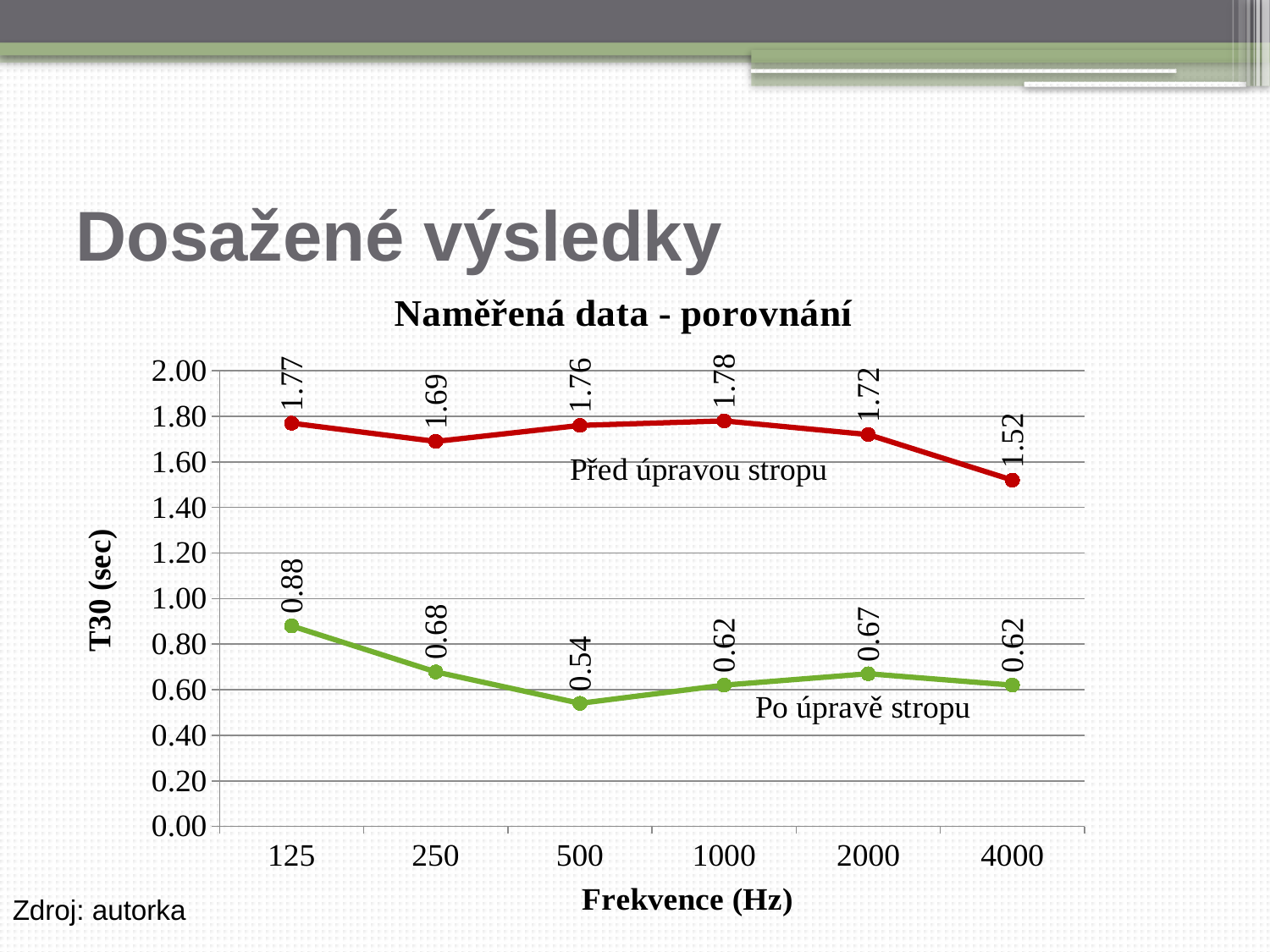
What type of chart is shown on the slide? line chart What is the T30 value for 'Po úpravě stropu' at 500 Hz? 0.54 How many frequency points are plotted on the x axis? 6 Which is larger for 'Po úpravě stropu': the value at 250 Hz or the value at 2000 Hz? 250 Hz At which frequency is the 'Před úpravou stropu' value lowest? 4000 What is the difference between the 'Před úpravou stropu' and 'Po úpravě stropu' values at 125 Hz? 0.89 What is the T30 value for 'Před úpravou stropu' at 4000 Hz? 1.52 What is the title of the chart? Naměřená data - porovnání What is the T30 value for 'Před úpravou stropu' at 1000 Hz? 1.78 At which frequency is the 'Po úpravě stropu' value highest? 125 Is the 'Po úpravě stropu' value at 125 Hz greater or less than 1.00? less How many data series are shown in the chart? 2